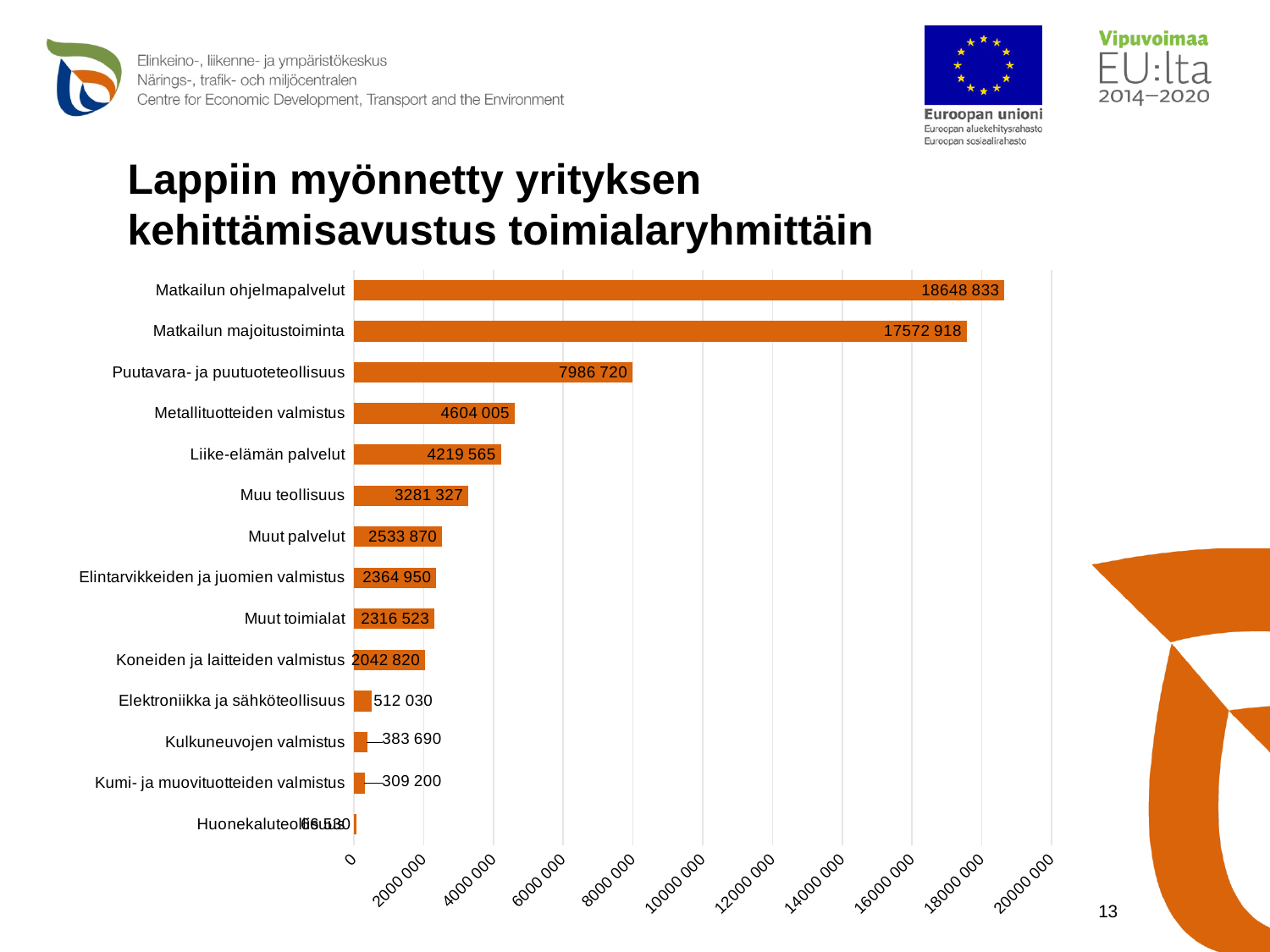
Which category has the highest value? Matkailun ohjelmapalvelut What value is shown for Elektroniikka ja sähköteollisuus? 512 030 Which is larger, the value for Metallituotteiden valmistus or the value for Liike-elämän palvelut? Metallituotteiden valmistus How many categories are shown in the chart? 14 Is the value for Muu teollisuus greater or less than 4000 000? less What value is shown for Matkailun ohjelmapalvelut? 18648 833 What value is shown for Puutavara- ja puutuoteteollisuus? 7986 720 What is the difference between the values for Matkailun ohjelmapalvelut and Matkailun majoitustoiminta? 1075 915 What kind of chart is shown on the slide? bar chart What value is shown for Kumi- ja muovituotteiden valmistus? 309 200 Which category has the lowest value? Huonekaluteollisuus What is the title of the slide? Lappiin myönnetty yrityksen kehittämisavustus toimialaryhmittäin